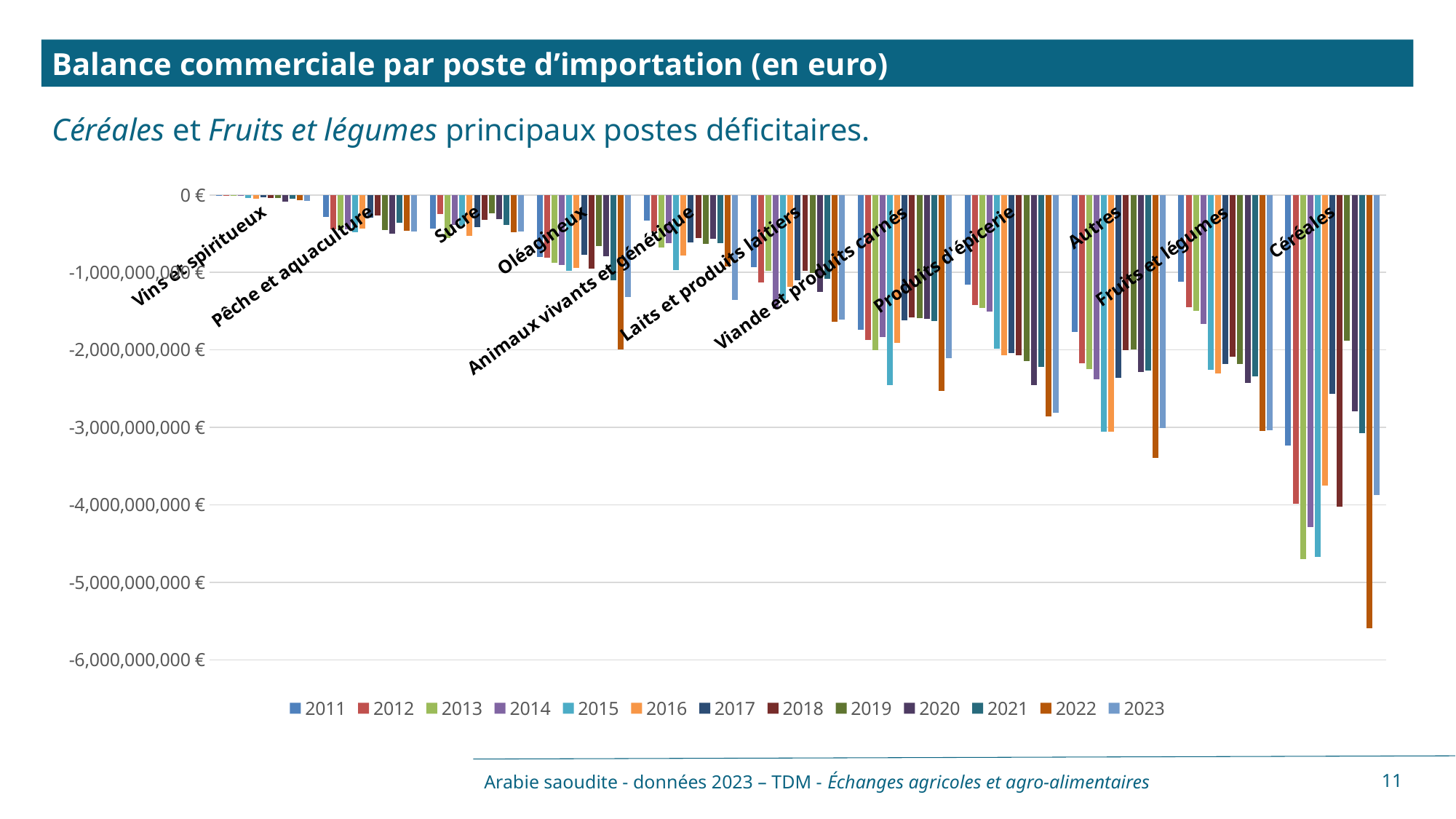
What is the title of the chart? Balance commerciale par poste d'importation (en euro) How many series does the legend list? 13 Which is more negative in 2022: Céréales or Fruits et légumes? Céréales Is the 2023 value for Vins et spiritueux greater or less than -1,000,000,000 €? greater What kind of chart is shown on the slide? bar chart Which year is the first series listed in the legend? 2011 How many import categories are shown on the x axis? 11 Which category has the most negative (lowest) trade balance values? Céréales Which category has trade balance values closest to zero (highest)? Vins et spiritueux Is the 2022 value for Céréales greater or less than -5,000,000,000 €? less Is the 2015 value for Céréales greater or less than -4,000,000,000 €? less